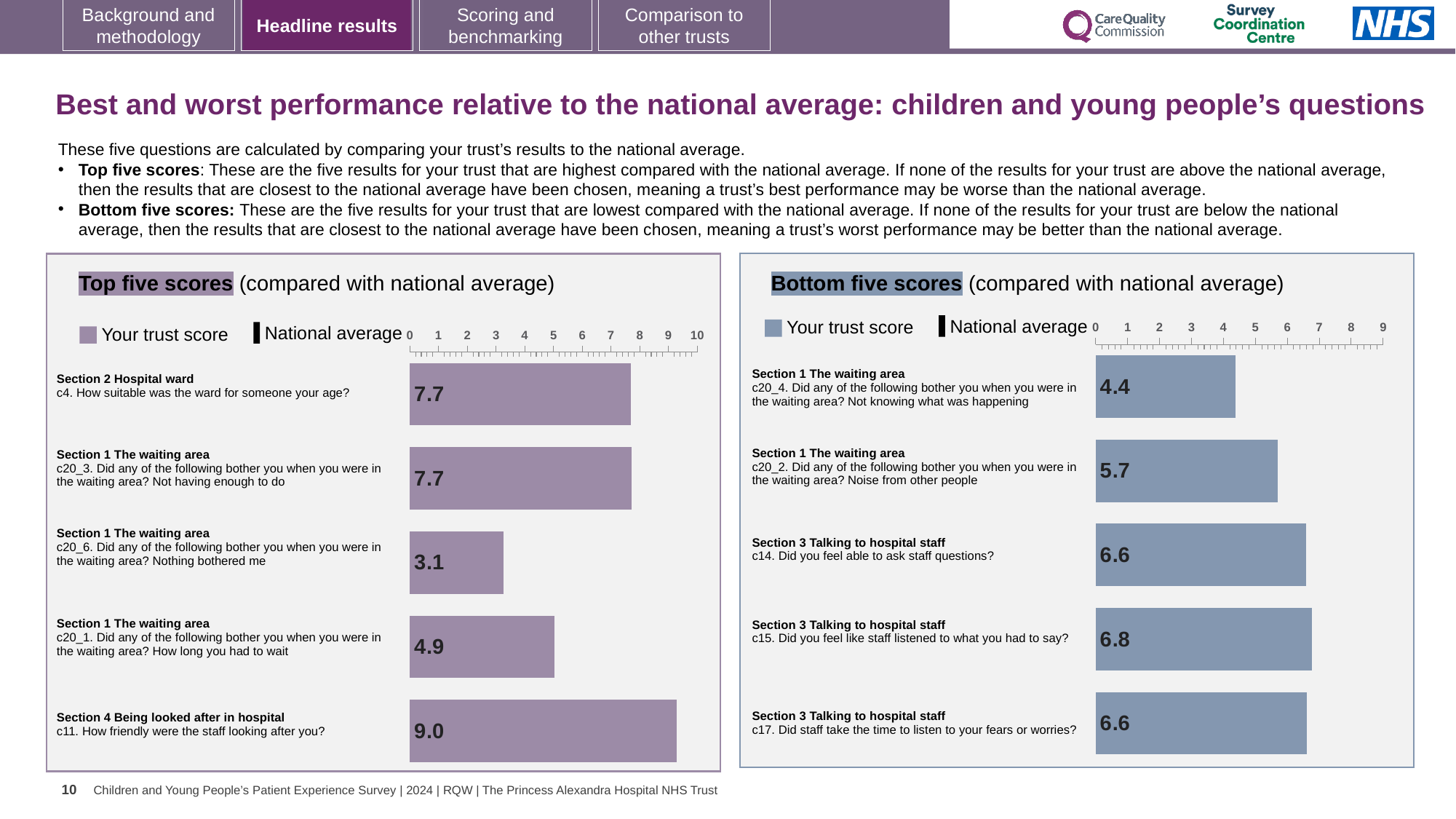
In the Bottom five scores chart, what is the trust score for c20_4. Did any of the following bother you when you were in the waiting area? Not knowing what was happening? 4.4 How many series does the legend of the Top five scores chart list? 2 In the Top five scores chart, what is the trust score for c11. How friendly were the staff looking after you? 9.0 In the Top five scores chart, what is the difference between the trust score for c11 and the trust score for c20_6? 5.9 In the Top five scores chart, which question has the highest trust score? c11. How friendly were the staff looking after you? In the Bottom five scores chart, what is the difference between the trust score for c15 and the trust score for c20_4? 2.4 What kind of chart is the Top five scores chart? Bar chart In the Bottom five scores chart, which has the larger trust score: c20_2 (Noise from other people) or c14 (Did you feel able to ask staff questions?)? c14. Did you feel able to ask staff questions? In the Bottom five scores chart, which question has the lowest trust score? c20_4. Did any of the following bother you when you were in the waiting area? Not knowing what was happening In the Bottom five scores chart, what is the trust score for c15. Did you feel like staff listened to what you had to say? 6.8 In the Top five scores chart, what is the trust score for c20_6. Did any of the following bother you when you were in the waiting area? Nothing bothered me? 3.1 How many questions are shown in the Bottom five scores chart? 5